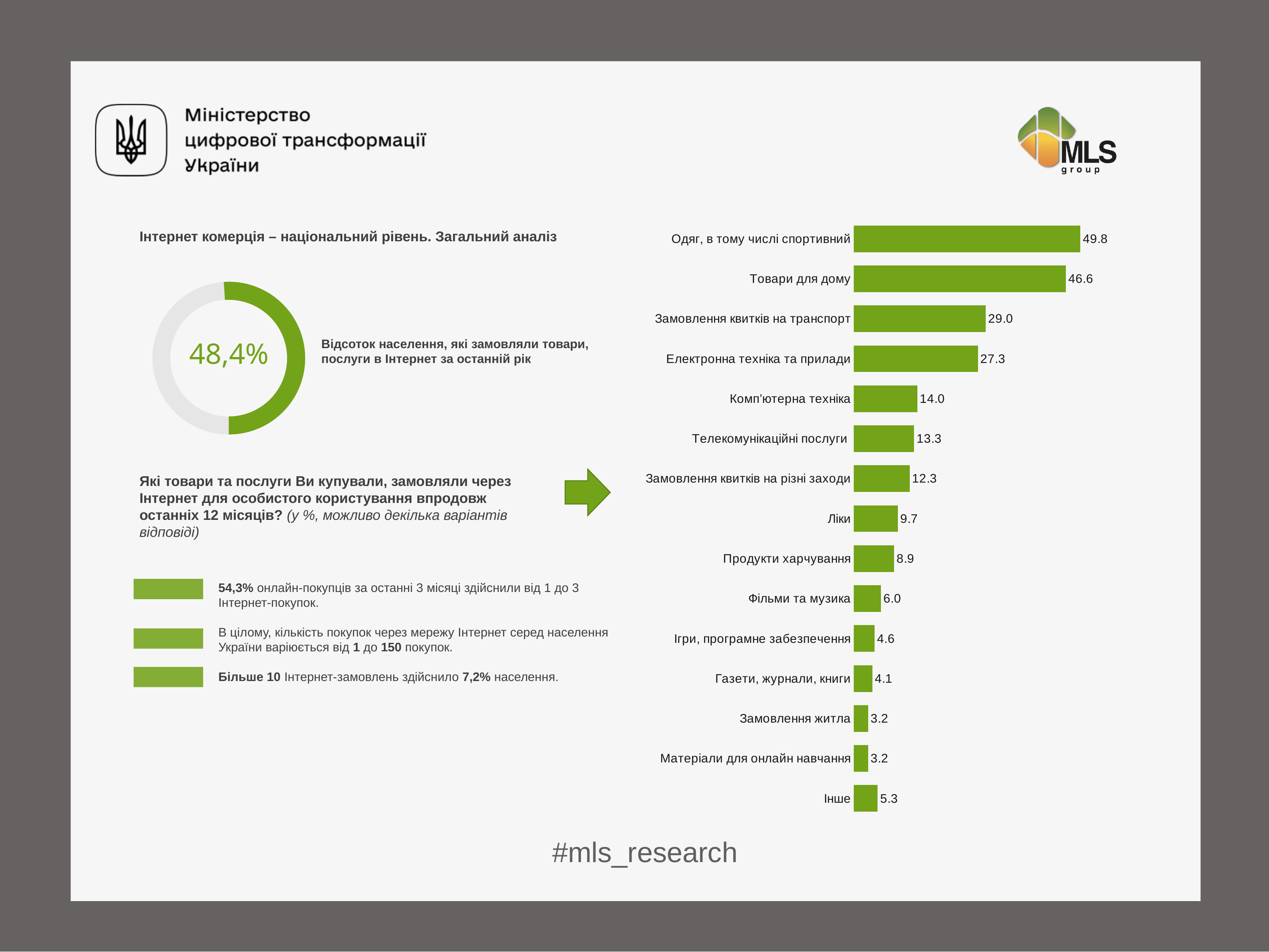
What kind of chart is shown on the right side of the slide? Bar chart What value is shown in the centre of the donut chart on the left? 48,4% In the bar chart on the right, what is the difference between Одяг, в тому числі спортивний and Товари для дому? 3.2 In the bar chart on the right, which is larger: Фільми та музика or Інше? Фільми та музика In the bar chart on the right, what is the value for Комп’ютерна техніка? 14.0 In the bar chart on the right, what is the value for Товари для дому? 46.6 How many categories does the bar chart on the right show? 15 In the bar chart on the right, what is the value for Ліки? 9.7 In the bar chart on the right, what is the difference between Замовлення квитків на транспорт and Електронна техніка та прилади? 1.7 In the bar chart on the right, which category has the lowest value, excluding Інше? Замовлення житла and Матеріали для онлайн навчання (both 3.2) In the bar chart on the right, which category has the highest value? Одяг, в тому числі спортивний What kind of chart is shown on the left side of the slide with the value 48,4%? Donut chart